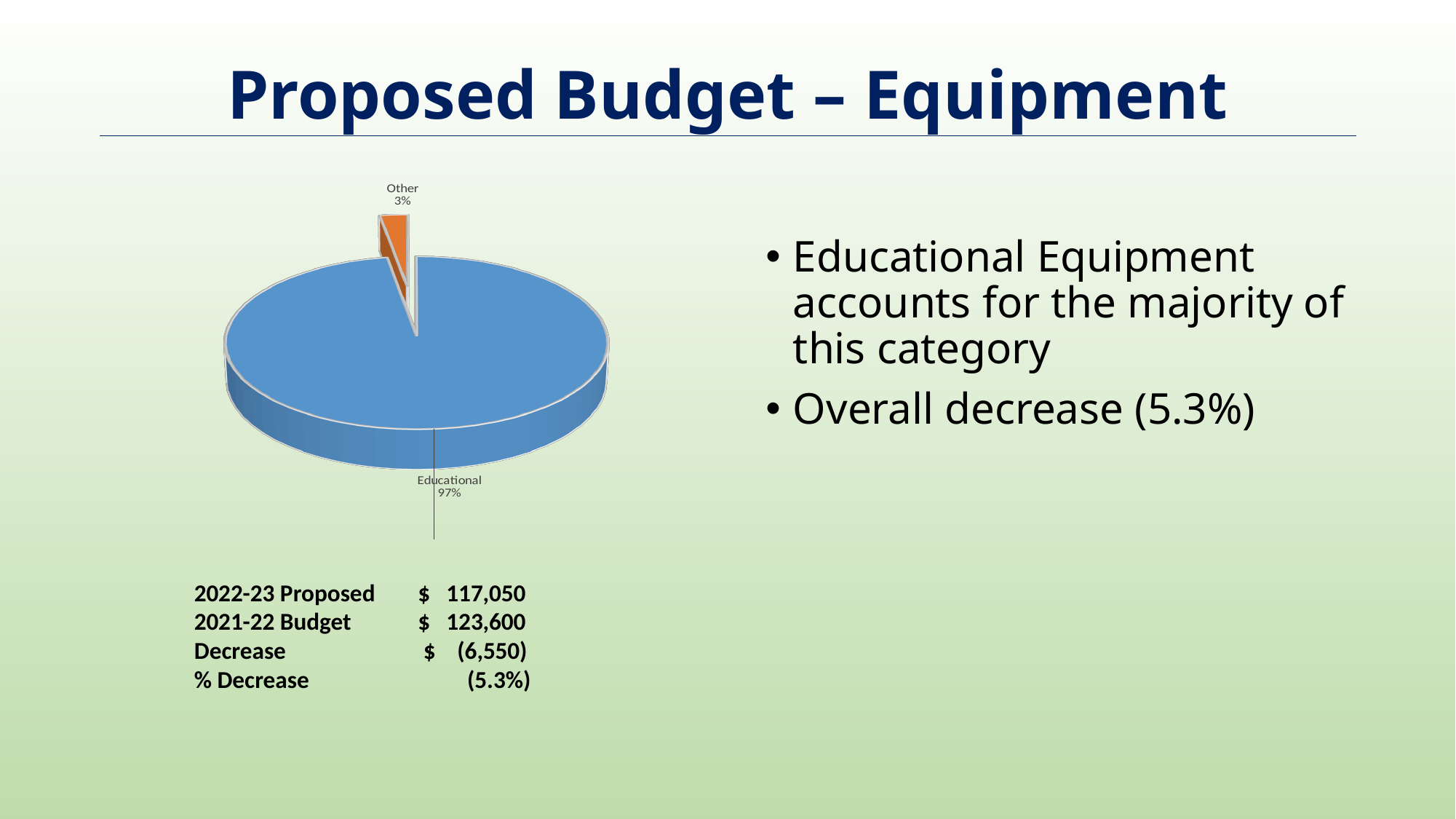
What kind of chart is shown on the slide? pie chart What share of the pie does Educational account for? 97% Which is larger, the Educational slice or the Other slice? Educational What colour is the Educational slice of the pie? blue What is the difference in percentage points between the Educational and Other slices? 94 Which slice of the pie is the smallest? Other What colour is the Other slice of the pie? orange What share of the pie does Other account for? 3% How many slices does the pie chart have? 2 Which slice of the pie is the largest? Educational